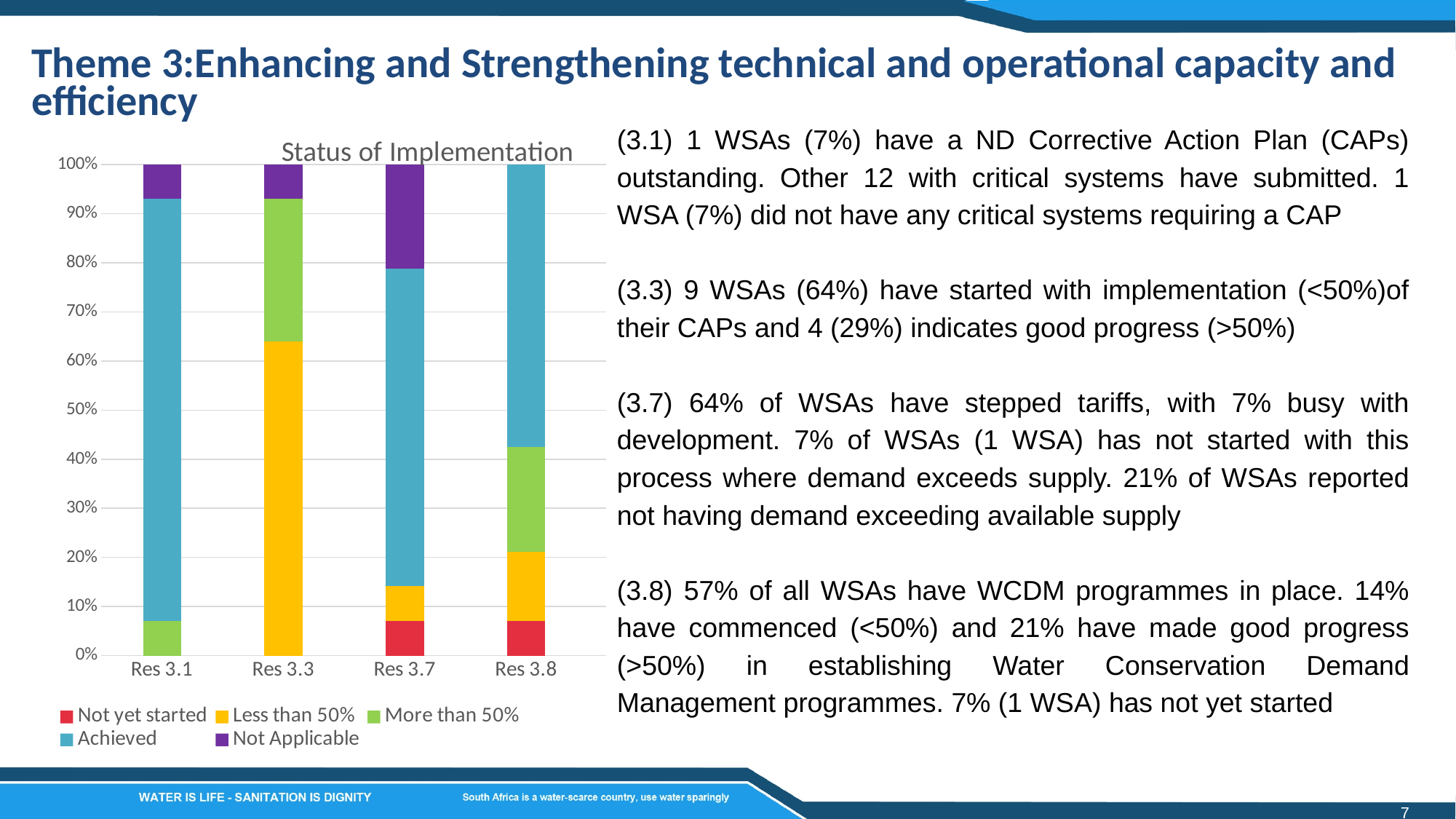
Which is larger: the Less than 50% segment for Res 3.3 or for Res 3.8? Res 3.3 What is the total height of the Res 3.1 stacked bar? 100% Which category has no Achieved segment at all? Res 3.3 Which category has the largest Not Applicable segment? Res 3.7 What is the title of the chart? Status of Implementation How many series does the chart legend list? 5 What kind of chart is shown on the slide? Stacked bar chart Is the Achieved segment for Res 3.8 greater or less than 50%? greater Which series is shown in red in the chart? Not yet started Which category has the largest Achieved segment? Res 3.1 Is the Less than 50% segment for Res 3.3 greater or less than 60%? greater How many categories are shown on the x axis of the chart? 4